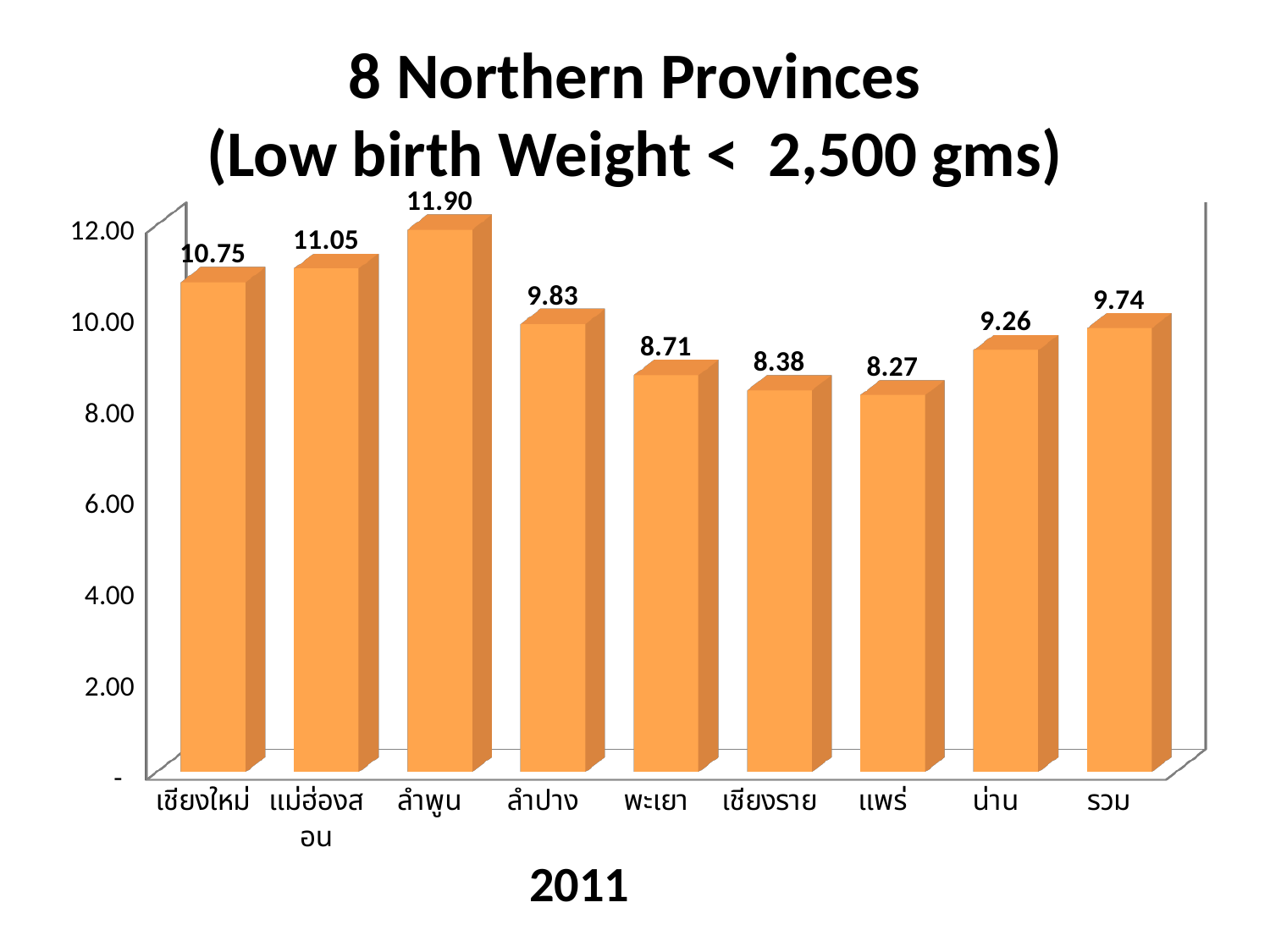
What is the value for ลำพูน? 11.90 What is the value for เชียงใหม่? 10.75 Is the value for แม่ฮ่องสอน greater or less than 10.00? greater What is the difference between the values for ลำพูน and แพร่? 3.63 What is the value for รวม? 9.74 What is the title of the chart? 8 Northern Provinces (Low birth Weight < 2,500 gms) Which category has the lowest value? แพร่ Which is larger, the value for น่าน or the value for พะเยา? น่าน What year is shown below the chart? 2011 What kind of chart is this? bar chart How many categories are shown on the x axis? 9 Which category has the highest value? ลำพูน